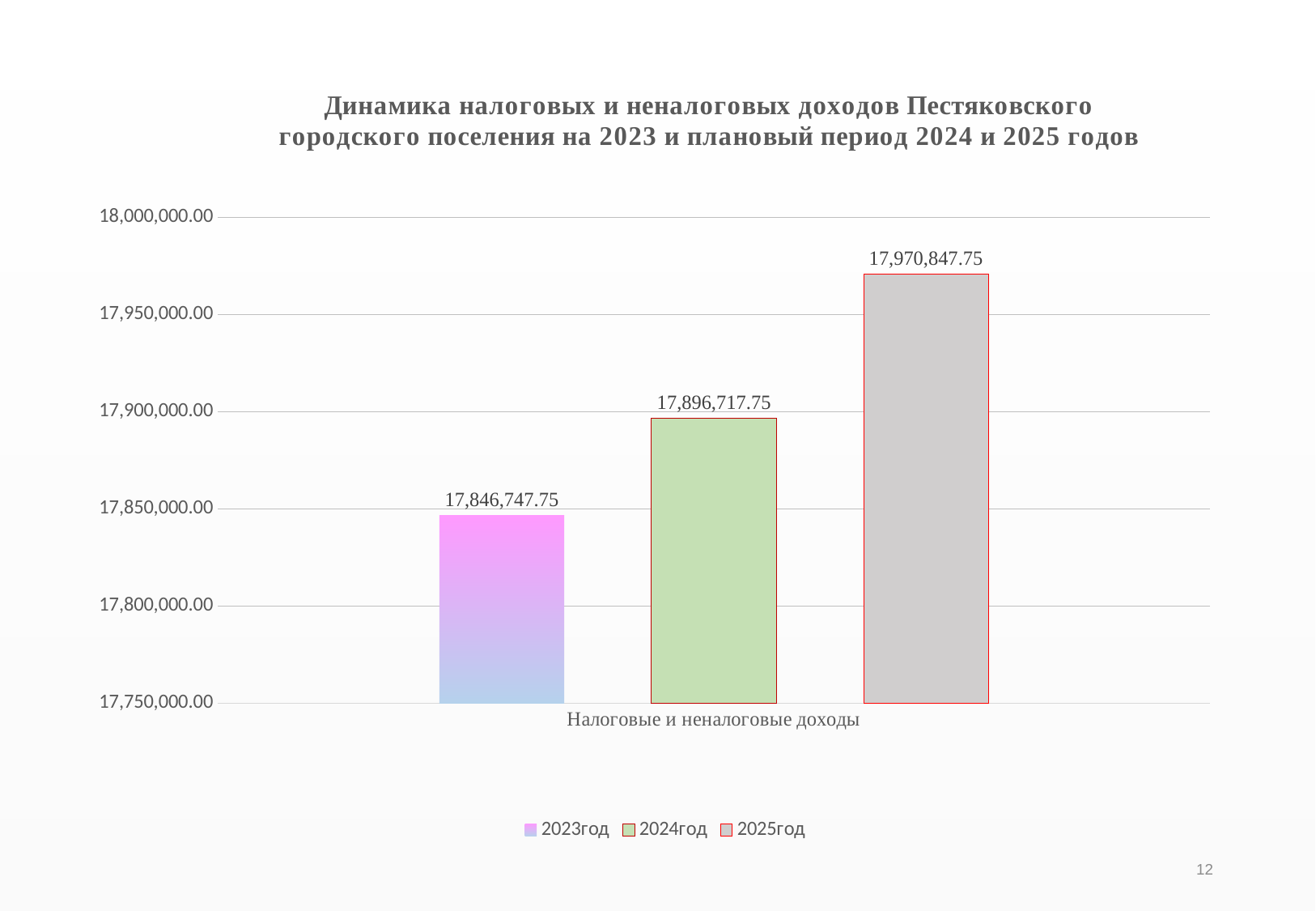
Which year has the lowest value? 2023год What is the difference between the values for 2025год and 2024год? 74,130.00 Is the value for 2023год greater or less than 17,850,000.00? less What is the value for 2025год? 17,970,847.75 What is the category label shown on the x axis? Налоговые и неналоговые доходы Which is larger, the value for 2024год or the value for 2025год? 2025год How many series does the legend list? 3 Which year has the highest value? 2025год What is the difference between the values for 2024год and 2023год? 49,970.00 What is the value for 2024год? 17,896,717.75 What kind of chart is shown on the slide? bar chart What is the value for 2023год? 17,846,747.75